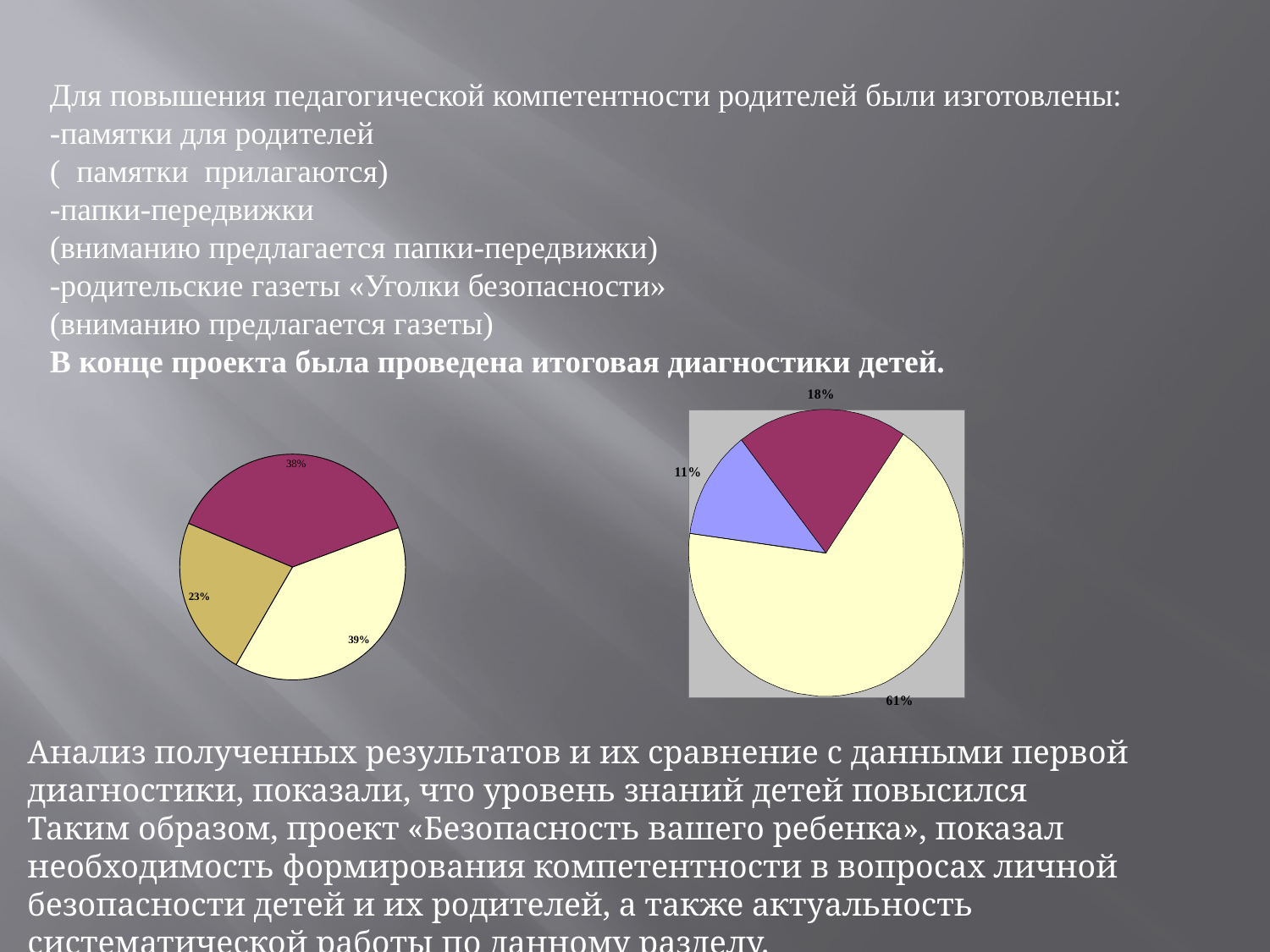
What kind of chart is the chart on the left of the slide? pie chart In the pie chart on the left of the slide, what share does the magenta slice have? 38% In the pie chart on the left of the slide, what share does the light yellow slice have? 39% How many slices does the pie chart on the left of the slide have? 3 In the pie chart on the right of the slide, what is the difference between the magenta slice and the blue slice? 7% In the pie chart on the right of the slide, what share does the blue slice have? 11% How many slices does the pie chart on the right of the slide have? 3 In the pie chart on the right of the slide, which slice is the largest? the light yellow slice (61%) What kind of chart is the chart on the right of the slide? pie chart In the pie chart on the left of the slide, which slice is the smallest? the gold slice (23%)